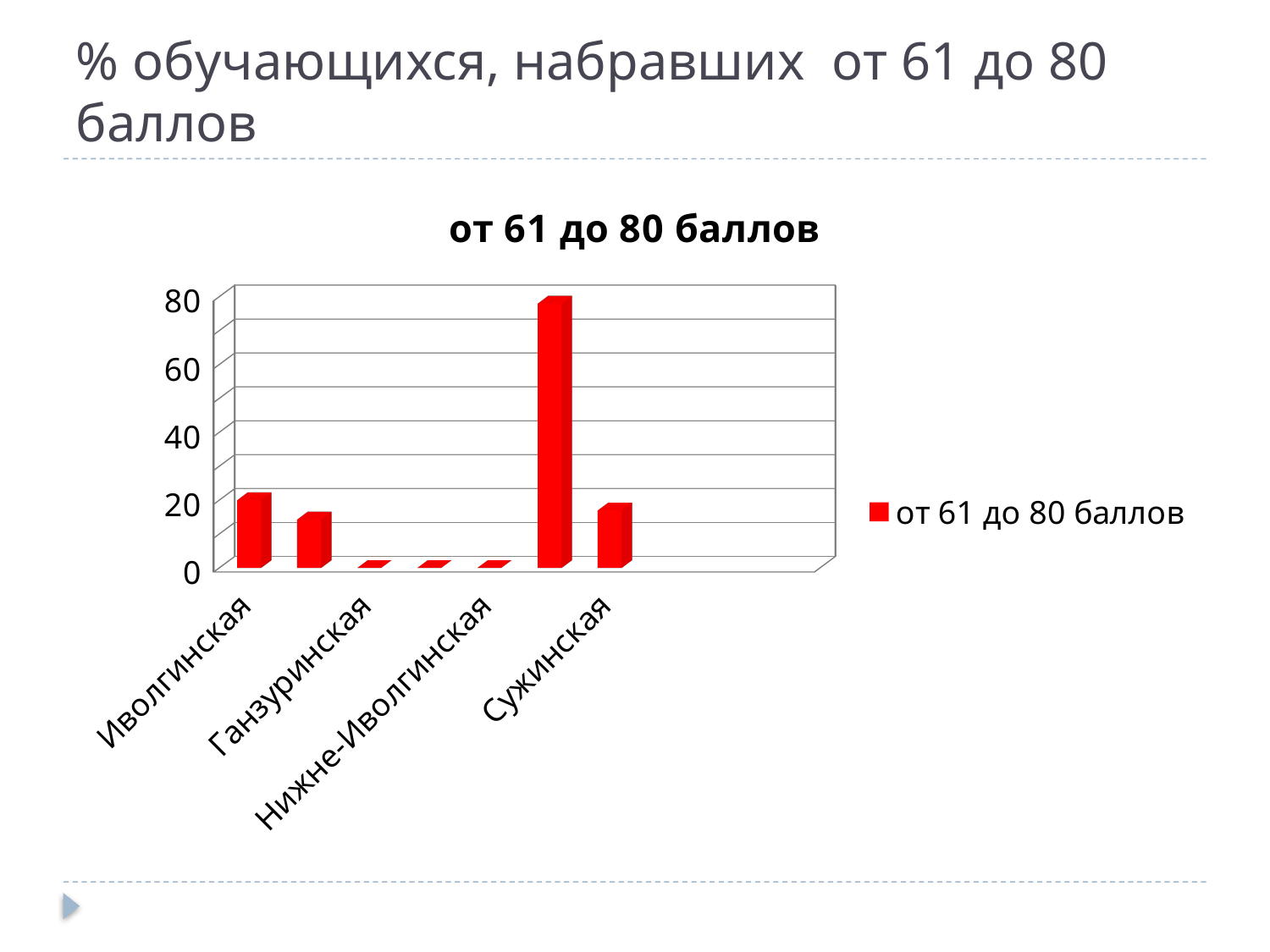
How many bars are plotted in the chart? 7 What kind of chart is shown on the slide? bar chart What is the title of the chart? от 61 до 80 баллов Which is larger, the value for Сужинская or the value for Нижне-Иволгинская? Сужинская Which is larger, the value for Иволгинская or the value for Ганзуринская? Иволгинская Is the value for Сужинская greater or less than 40? less What is the value for Нижне-Иволгинская? 0 Is the value for Иволгинская greater or less than 40? less What colour are the bars in the chart? red How many series does the legend list? 1 What is the value for Ганзуринская? 0